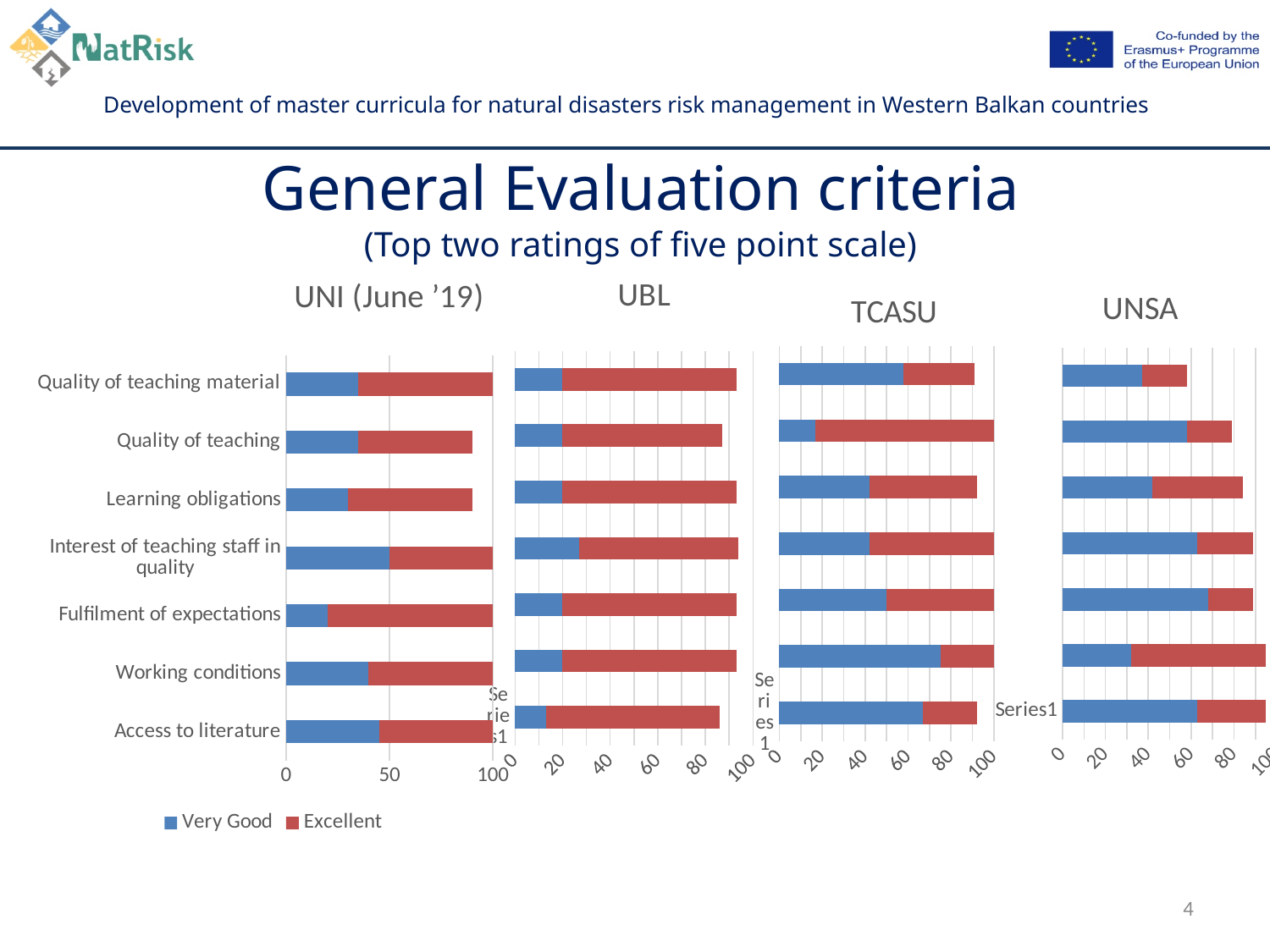
In the UNI (June '19) chart, which category has the lowest Very Good value? Fulfilment of expectations In the TCASU chart, which is larger, the Very Good value for Working conditions or the Very Good value for Quality of teaching? Working conditions How many series does the legend below the UNI (June '19) chart list? 2 In the UNI (June '19) chart, is the Very Good value for Fulfilment of expectations greater or less than 50? less What are the two series named in the legend below the UNI (June '19) chart? Very Good and Excellent In the UNSA chart, is the Very Good value for Fulfilment of expectations greater or less than 60? greater In the UBL chart, which category has the highest Very Good value? Interest of teaching staff in quality In the TCASU chart, is the Very Good value for Working conditions greater or less than 60? greater How many categories are listed on the y axis of the UNI (June '19) chart? 7 What kind of chart is the UNI (June '19) chart? stacked bar chart In the UNSA chart, which category has the lowest combined (Very Good plus Excellent) bar? Quality of teaching material